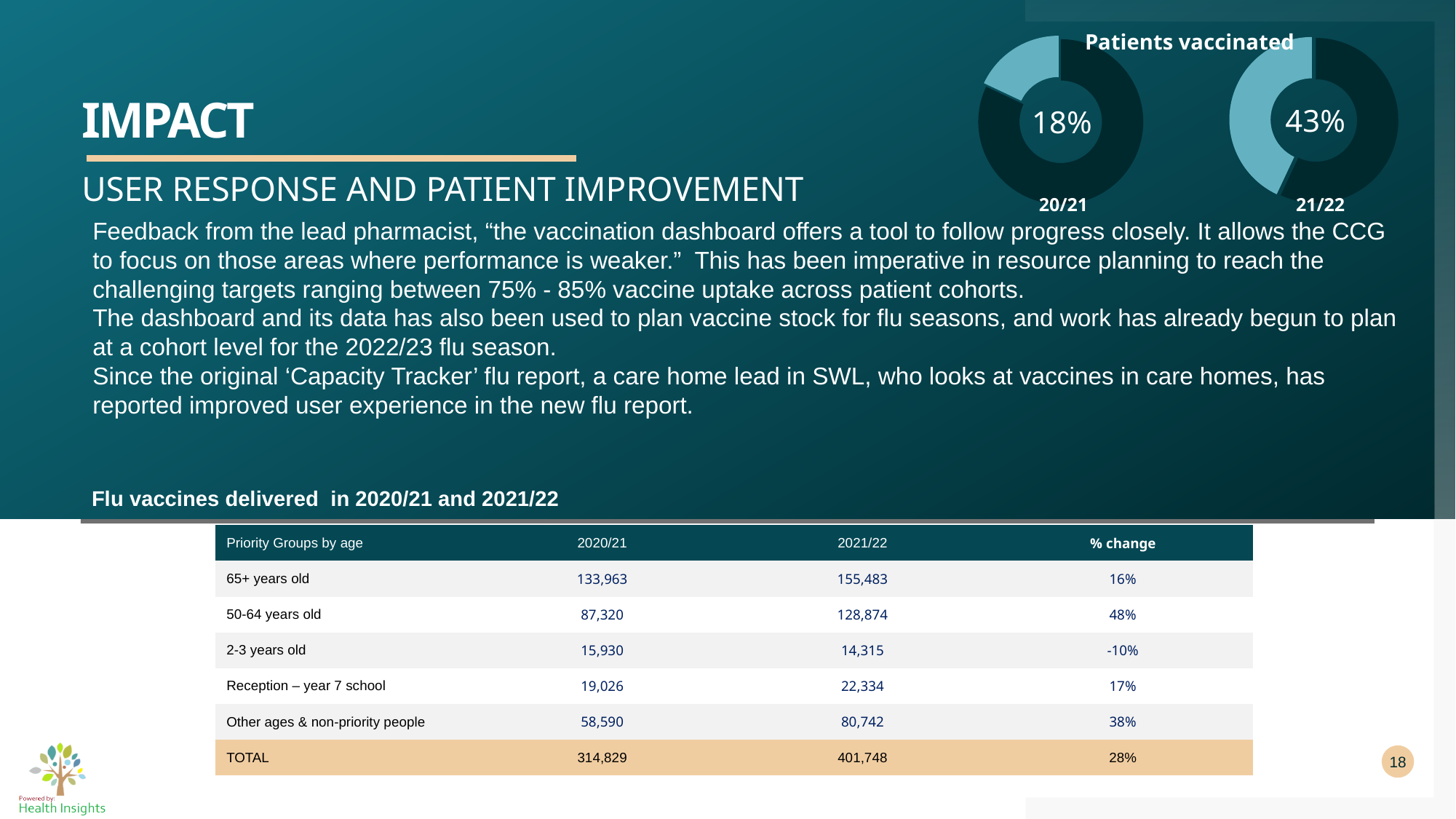
In the 'Patients vaccinated' charts, by how many percentage points does the 21/22 value exceed the 20/21 value? 25 percentage points What are the two period labels shown beneath the 'Patients vaccinated' donut charts? 20/21 and 21/22 What kind of chart is used to show 'Patients vaccinated'? Donut (pie) chart In the 'Patients vaccinated' charts, which period shows the higher vaccinated percentage, 20/21 or 21/22? 21/22 In the 'Patients vaccinated' charts, which period has the lowest vaccinated percentage? 20/21 Does the vaccinated percentage rise or fall from 20/21 to 21/22 in the 'Patients vaccinated' charts? Rise How many donut charts are shown under the 'Patients vaccinated' heading? 2 In the 'Patients vaccinated' charts, what percentage of patients were vaccinated in 21/22? 43% In the 20/21 'Patients vaccinated' donut, what share of the ring does the light-coloured (vaccinated) slice represent? 18% What is the title shown above the two donut charts in the top right of the slide? Patients vaccinated In the 'Patients vaccinated' charts, what percentage of patients were vaccinated in 20/21? 18%